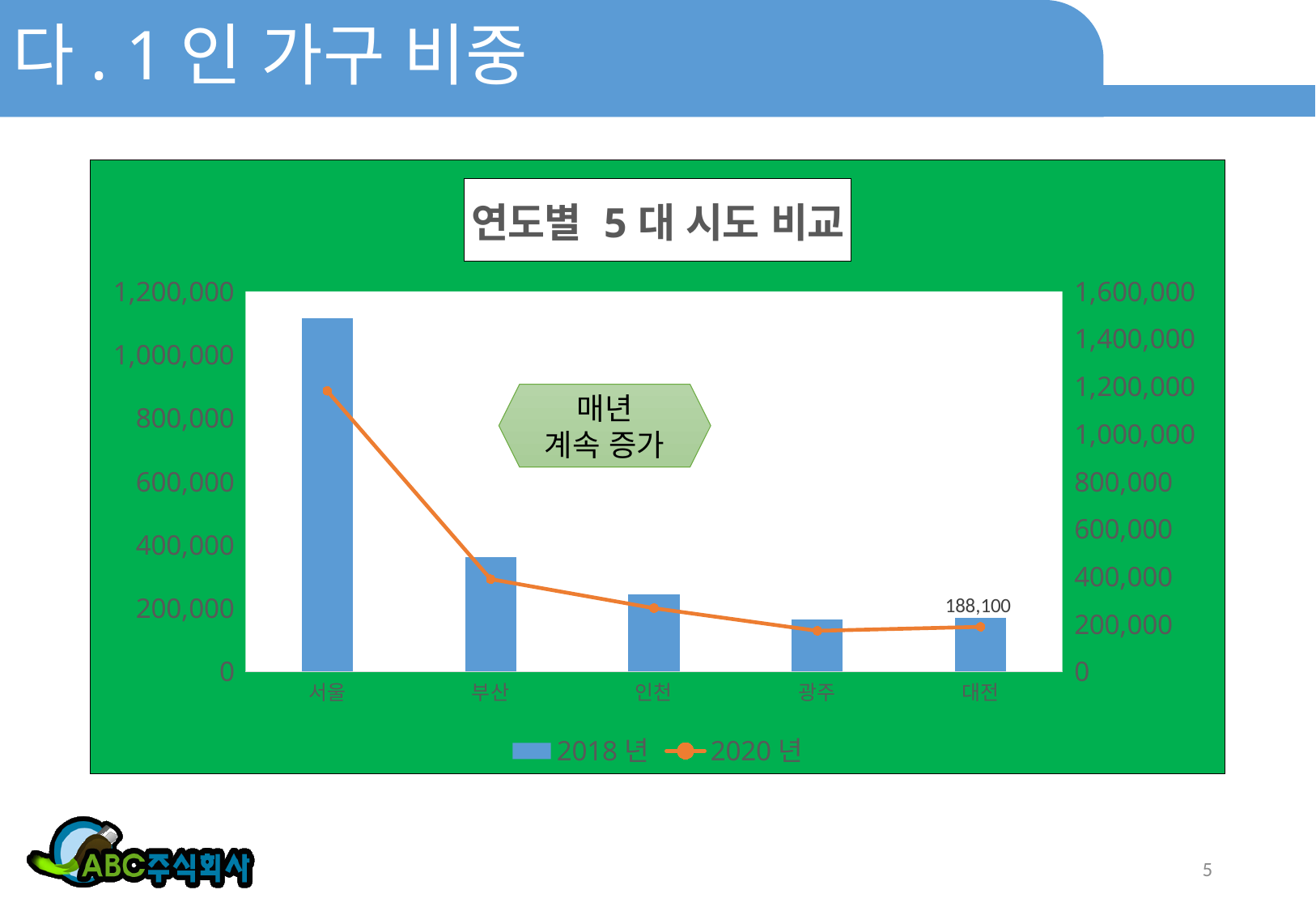
Is the 2018 년 value for 부산 greater or less than 400,000 on the left axis? less How many series does the chart legend list? 2 Which city has the larger 2018 년 bar, 인천 or 광주? 인천 What kind of chart is shown on the slide? A combination bar and line chart Is the 2020 년 value for 서울 greater or less than 1,000,000 on the right axis? greater Is the 2018 년 value for 서울 greater or less than 1,000,000 on the left axis? greater Do the 2018 년 bars rise or fall from 서울 to 광주? fall What value is printed as a data label at 대전? 188,100 What is the title of the chart? 연도별 5 대 시도 비교 Which city has the lowest point on the 2020 년 line? 광주 Which city has the highest 2018 년 bar? 서울 How many cities are shown on the x axis of the chart? 5